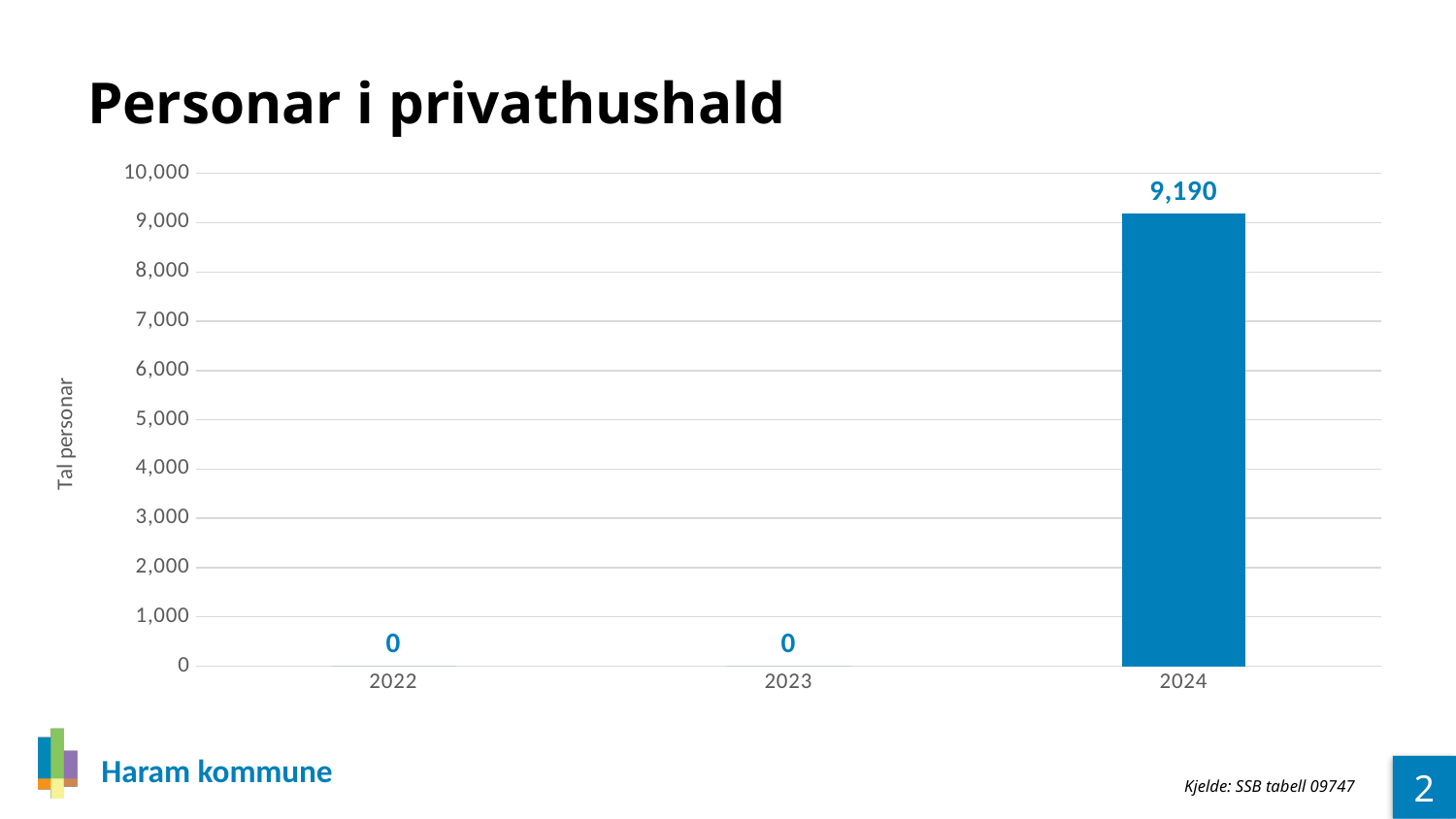
What is the value for 2024? 9,190 What is the value for 2023? 0 What is the difference between the values for 2024 and 2023? 9,190 What is the label of the y axis? Tal personar How many years are shown on the x axis? 3 Is the value for 2024 greater or less than 9,000? greater What is the value for 2022? 0 What kind of chart is shown on the slide? bar chart Do the values rise or fall from 2022 to 2024? rise Which year has the highest value? 2024 What is the title of the chart? Personar i privathushald Which is larger, the value for 2024 or the value for 2022? 2024